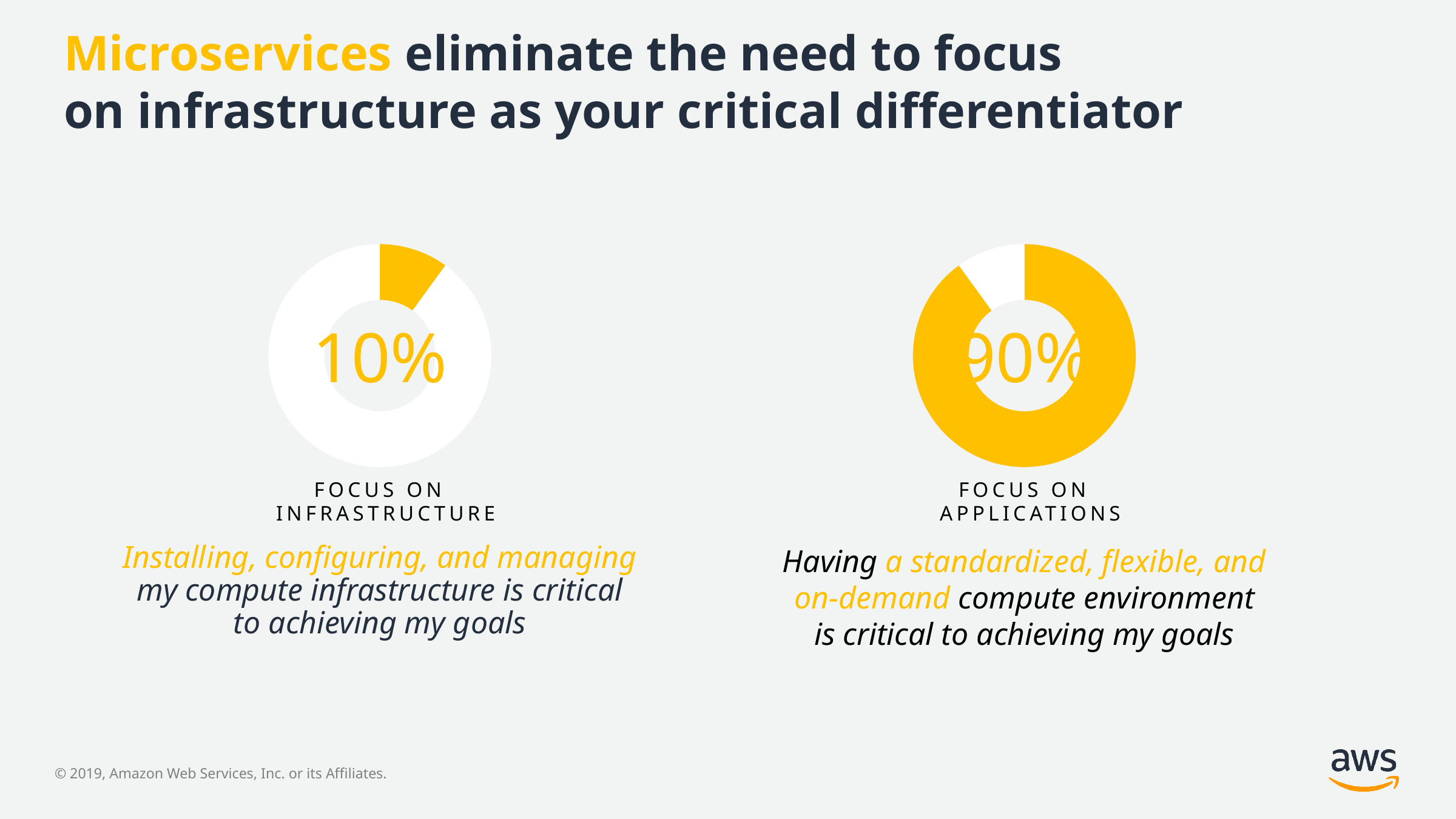
What is the label beneath the left doughnut chart? Focus on infrastructure On the left chart labelled 'Focus on infrastructure', what percentage is shown in the centre? 10% What colour is the filled portion of the doughnut charts? Yellow Which of the two charts shows the larger percentage, 'Focus on infrastructure' or 'Focus on applications'? Focus on applications On the right chart labelled 'Focus on applications', what percentage is shown in the centre? 90% On the right chart, is the value for 'Focus on applications' greater or less than 50%? greater How many doughnut charts are shown on the slide? 2 On the left chart, is the value for 'Focus on infrastructure' greater or less than 50%? less What kind of chart is used for the 'Focus on infrastructure' figure? Doughnut chart What is the difference between the percentage on the 'Focus on applications' chart and the percentage on the 'Focus on infrastructure' chart? 80% What do the percentages on the two charts add up to? 100%